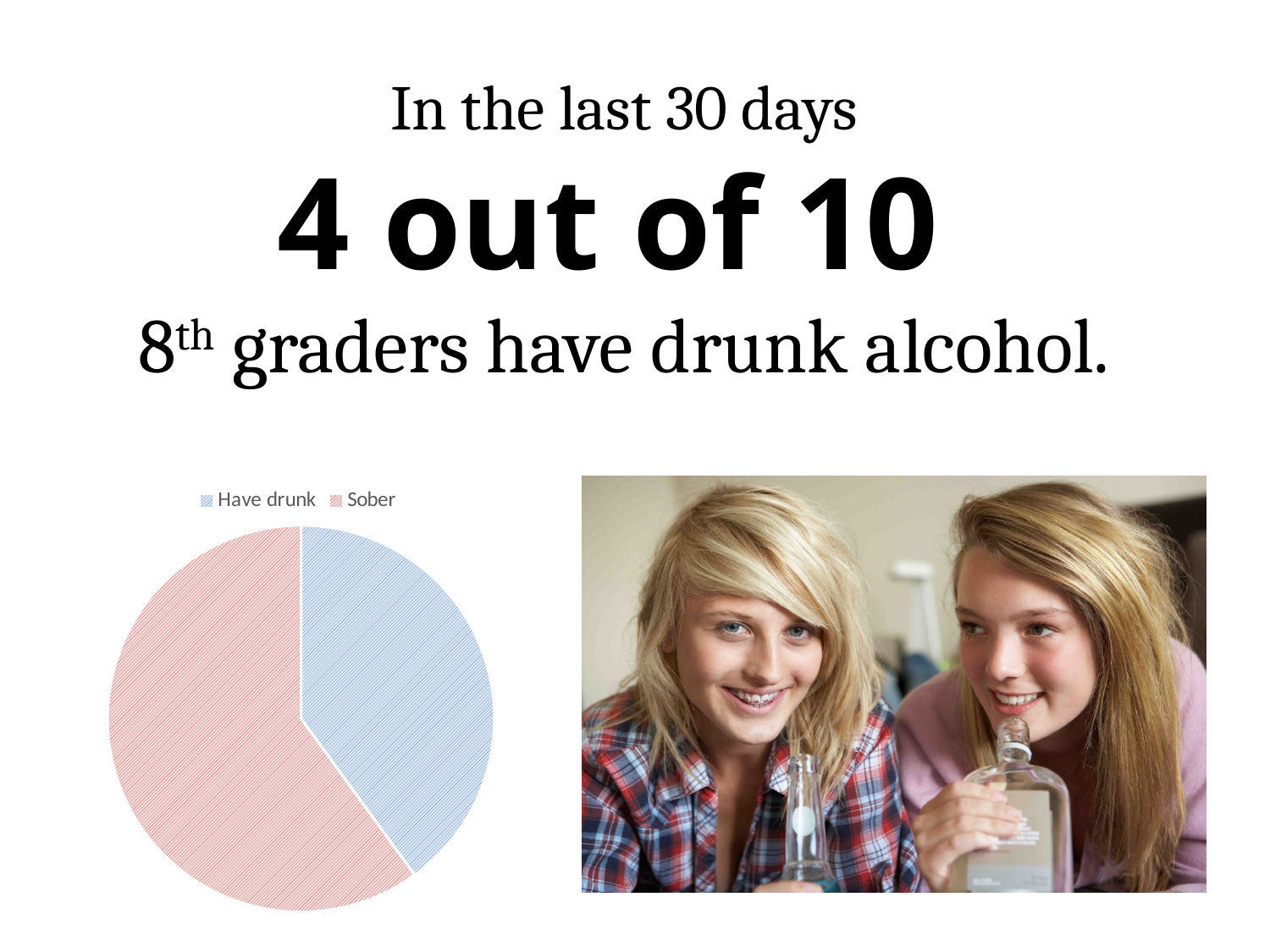
How many slices does the pie chart have? 2 Which slice of the pie chart is the smallest? Have drunk What colour is the Have drunk slice in the pie chart? blue What are the two legend entries of the pie chart? Have drunk, Sober Which slice of the pie chart is the largest? Sober In the pie chart, which slice is larger, Have drunk or Sober? Sober What kind of chart is shown on the slide? pie chart How many entries does the pie chart's legend list? 2